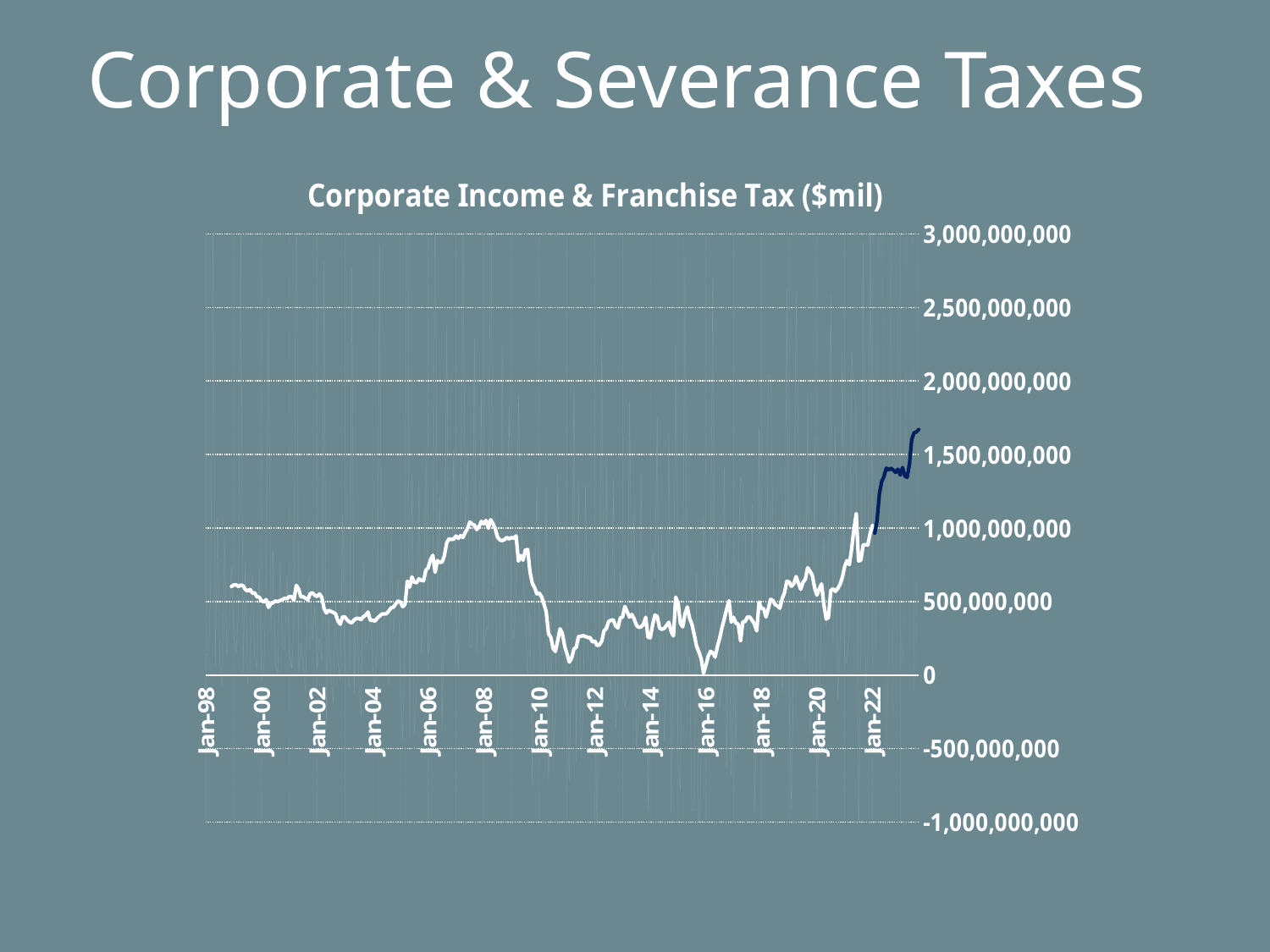
Which is larger, the value at Jan-22 or the value at Jan-98? Jan-22 What kind of chart is shown on the slide? line chart Does the line rise or fall between Jan-16 and Jan-22? rise What is the title of the chart? Corporate Income & Franchise Tax ($mil) Is the value at Jan-12 greater or less than 500,000,000? less Is the value at Jan-16 greater or less than 500,000,000? less Does the line rise or fall between Jan-08 and Jan-10? fall Among the labeled x-axis dates, at which is the line lowest? Jan-16 Is the value at Jan-08 greater or less than 500,000,000? greater How many year labels are shown on the x axis? 13